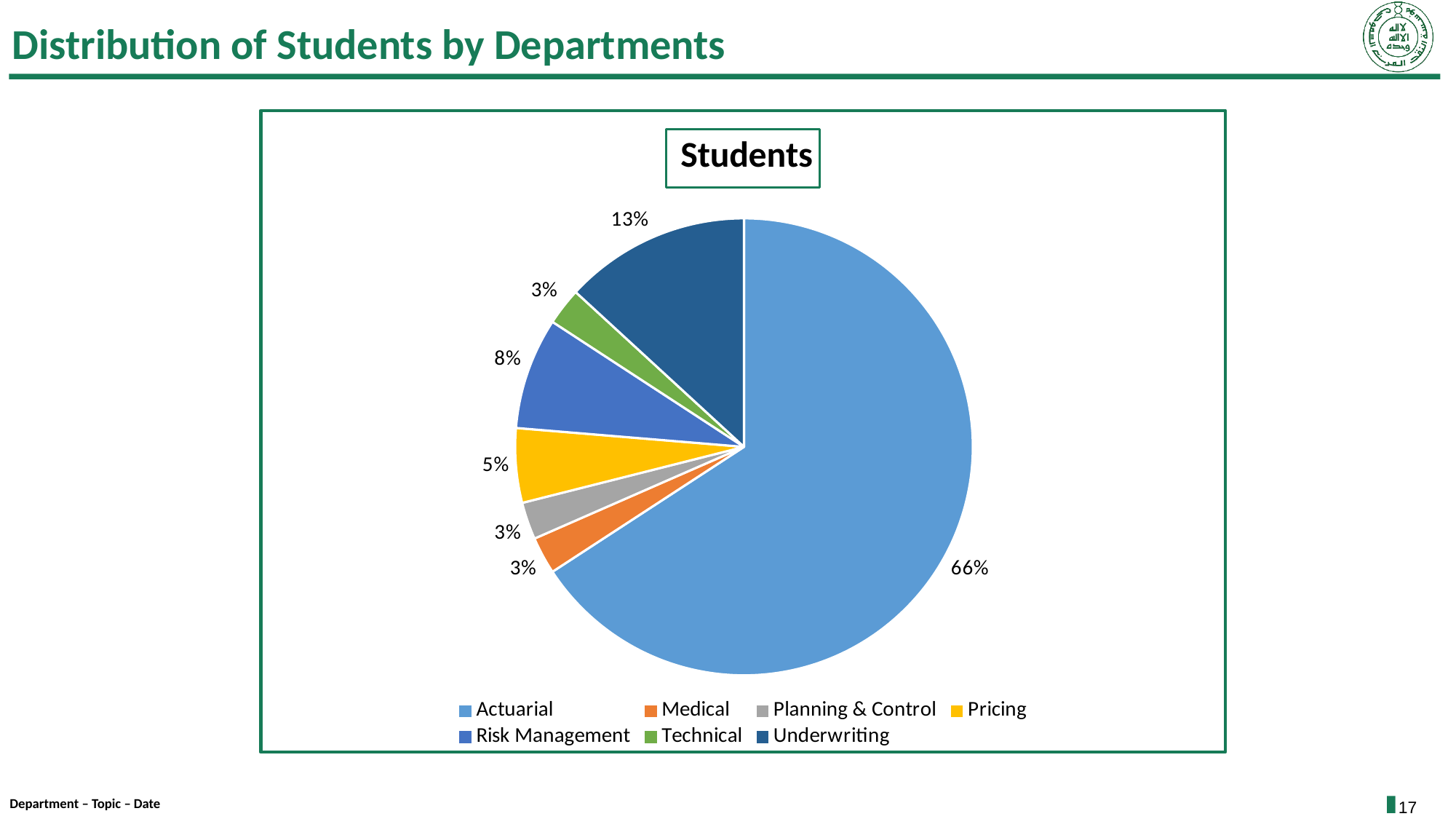
Which department is represented by the orange slice? Medical Which department has the largest share of students? Actuarial What share of students is in the Pricing department? 5% What share of students is in the Underwriting department? 13% What is the title shown above the pie chart? Students What share of students is in the Risk Management department? 8% Which has a larger share of students, Risk Management or Pricing? Risk Management What share of students is in the Actuarial department? 66% What is the difference in percentage points between the Actuarial and Underwriting shares? 53 What type of chart is shown on the slide? Pie chart What share of students is in the Technical department? 3% How many departments are shown in the pie chart? 7